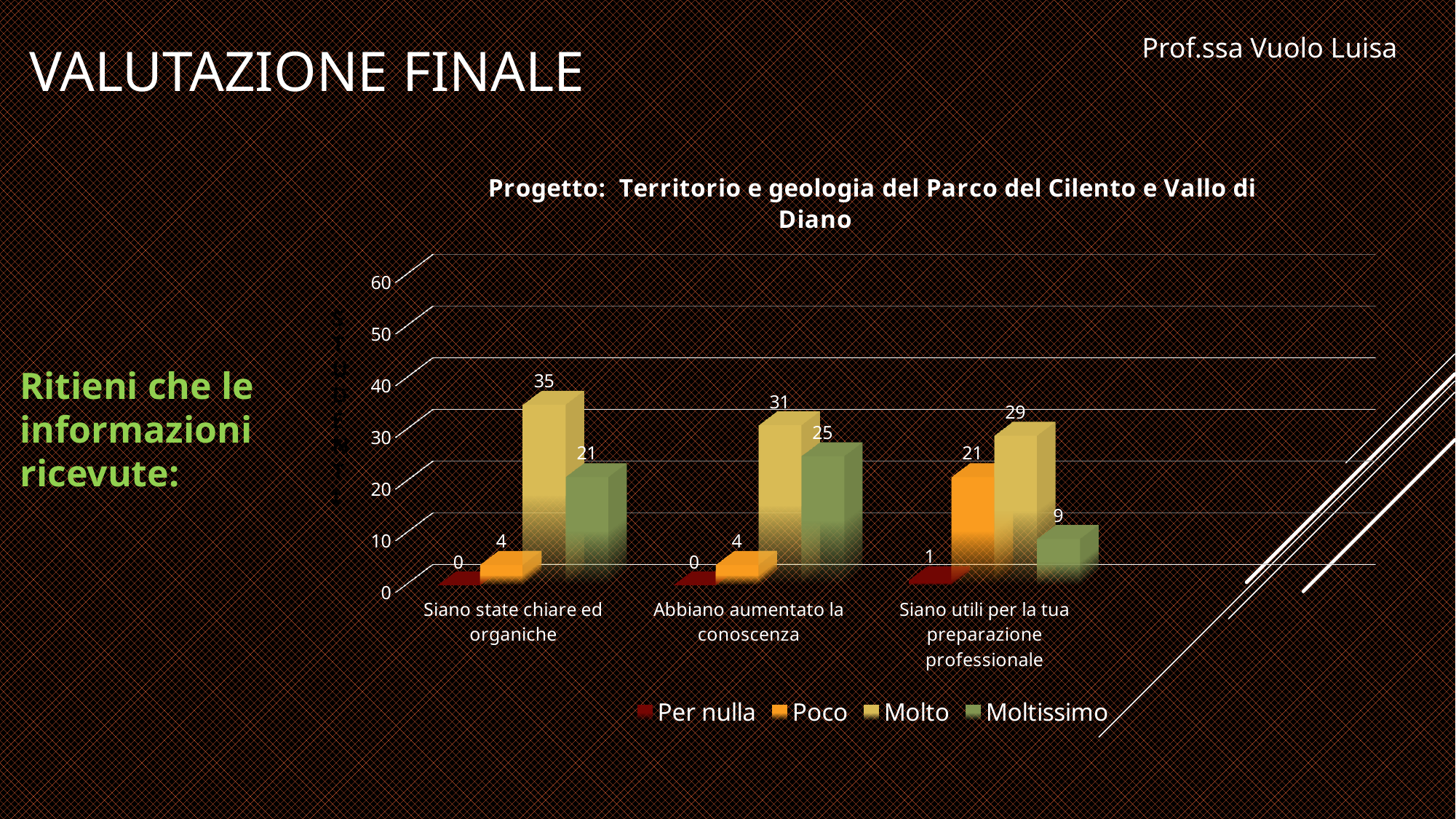
What is the value of the "Per nulla" series for "Siano utili per la tua preparazione professionale"? 1 What is the title of the chart? Progetto: Territorio e geologia del Parco del Cilento e Vallo di Diano What is the value of the "Molto" series for "Siano state chiare ed organiche"? 35 What is the value of the "Poco" series for "Siano utili per la tua preparazione professionale"? 21 What is the value of the "Moltissimo" series for "Abbiano aumentato la conoscenza"? 25 Which is larger for "Abbiano aumentato la conoscenza": the "Molto" value or the "Moltissimo" value? Molto What is the difference between the "Molto" and "Moltissimo" values for "Siano state chiare ed organiche"? 14 What kind of chart is shown on the slide? Bar chart How many series does the legend list? 4 Which category has the highest value for the "Molto" series? Siano state chiare ed organiche How many categories are shown on the x axis? 3 Which category has the lowest value for the "Moltissimo" series? Siano utili per la tua preparazione professionale